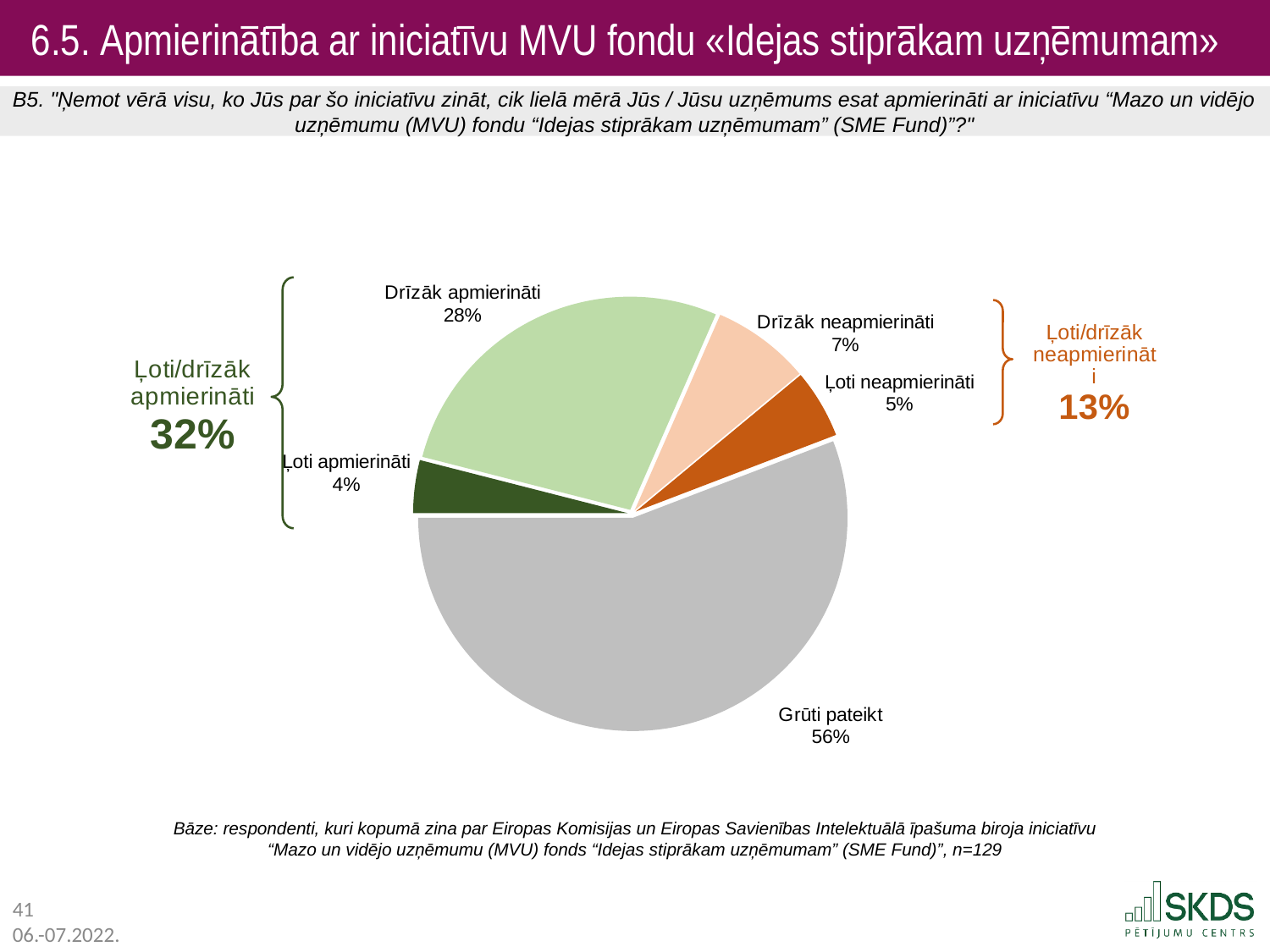
What share of respondents answered "Drīzāk apmierināti"? 28% What combined share is shown for "Ļoti/drīzāk apmierināti"? 32% Which slice of the pie is the largest? Grūti pateikt How many slices does the pie chart have? 5 What share of respondents answered "Ļoti apmierināti"? 4% Which is larger, the share for "Drīzāk neapmierināti" or for "Ļoti neapmierināti"? Drīzāk neapmierināti What share of respondents answered "Ļoti neapmierināti"? 5% What share of respondents answered "Drīzāk neapmierināti"? 7% What share of respondents answered "Grūti pateikt"? 56% What is the difference between the shares for "Drīzāk apmierināti" and "Drīzāk neapmierināti"? 21 percentage points Which slice of the pie is the smallest? Ļoti apmierināti What kind of chart is shown on the slide? pie chart